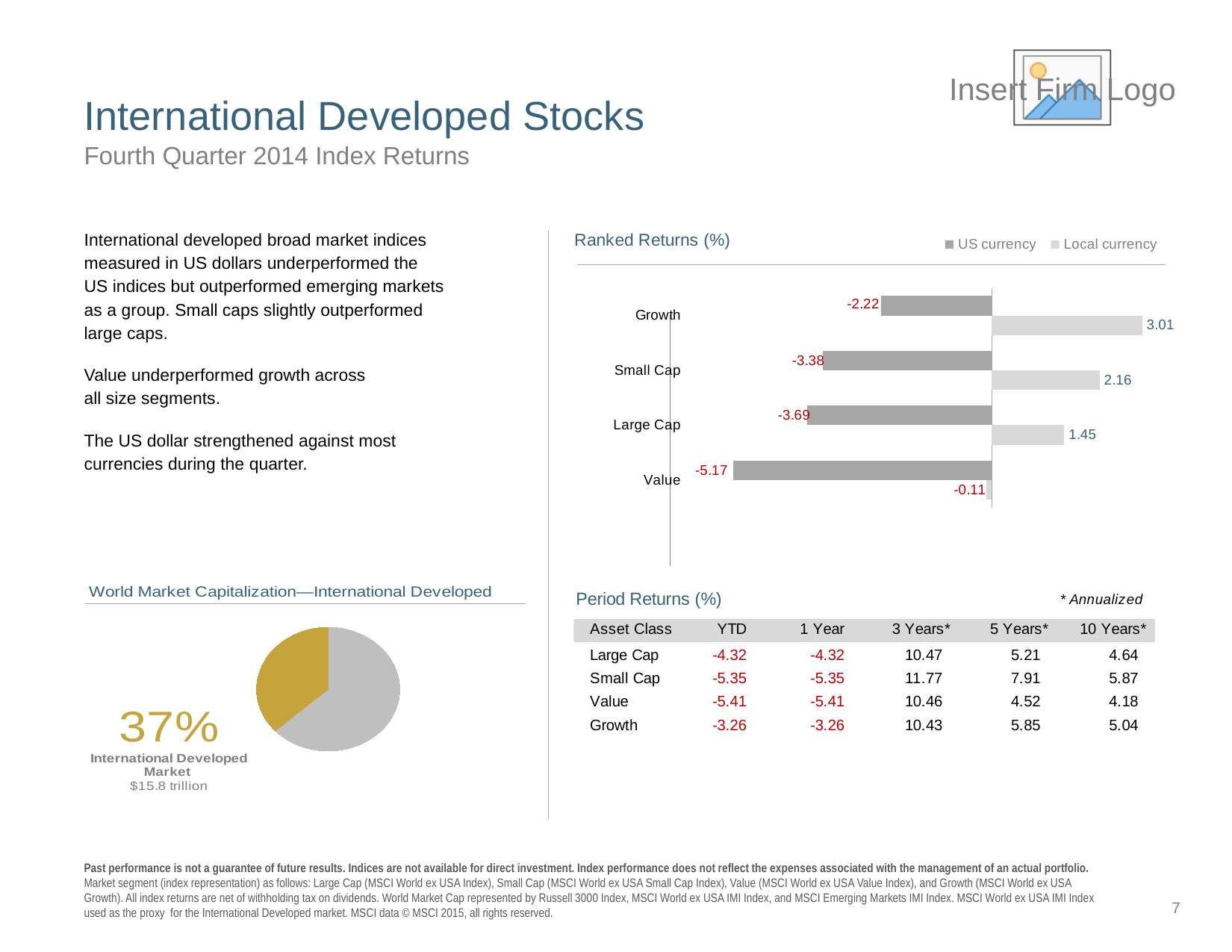
In the Ranked Returns (%) chart, what is the difference between the Local currency and US currency returns for Growth? 5.23 In the Ranked Returns (%) chart, what is the Local currency return for Small Cap? 2.16 How many categories are shown in the Ranked Returns (%) chart? 4 In the Ranked Returns (%) chart, which category has the lowest US currency return? Value In the Ranked Returns (%) chart, what is the Local currency return for Value? -0.11 In the Ranked Returns (%) chart, what is the US currency return for Growth? -2.22 How many series does the legend of the Ranked Returns (%) chart list? 2 In the Ranked Returns (%) chart, which category has the highest Local currency return? Growth What kind of chart is the Ranked Returns (%) chart? Bar chart In the World Market Capitalization—International Developed pie chart, what share does the International Developed Market slice represent? 37% What are the two legend entries in the Ranked Returns (%) chart? US currency and Local currency In the Ranked Returns (%) chart, which has the higher US currency return, Small Cap or Large Cap? Small Cap